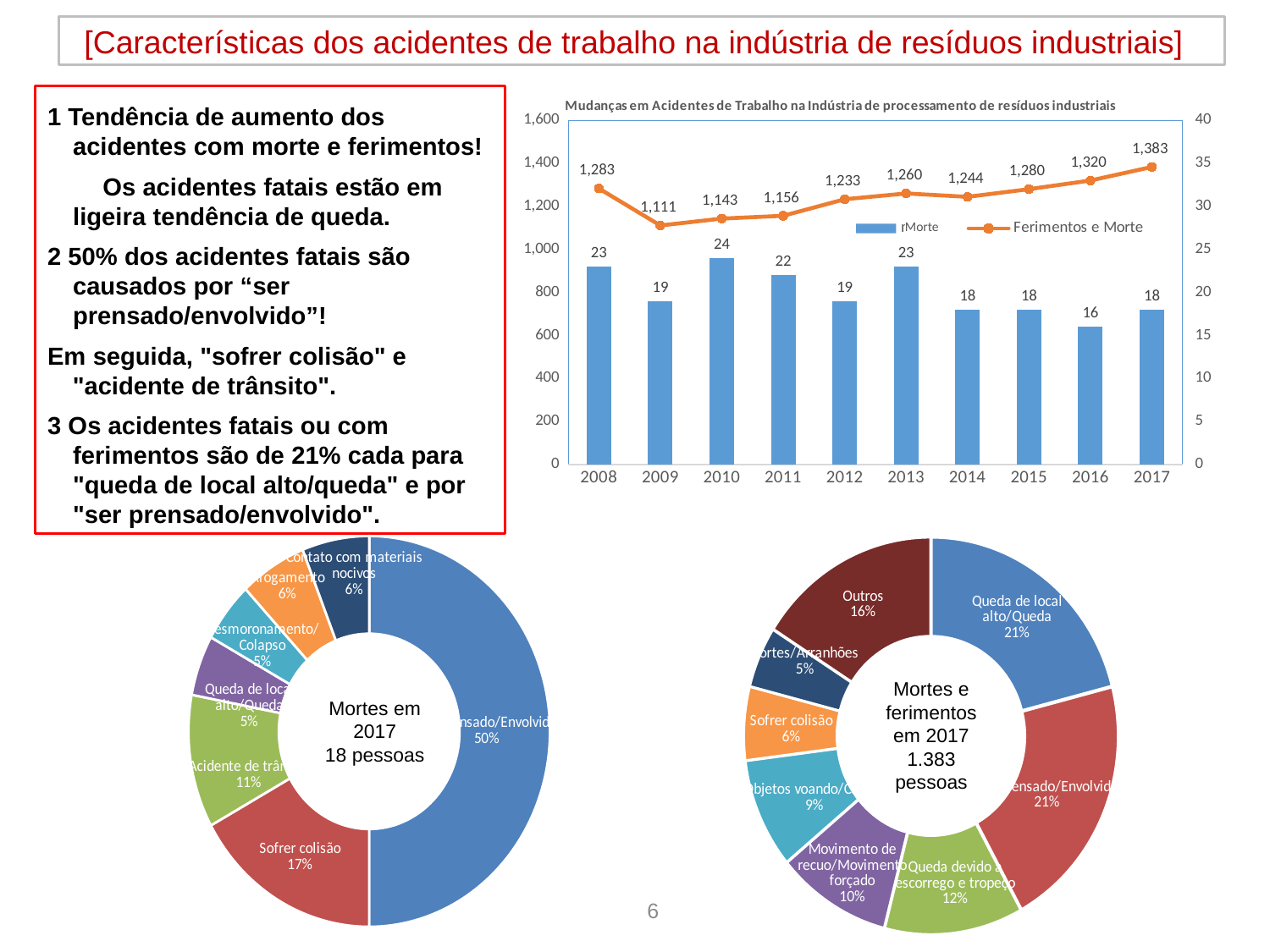
In the chart 'Mudanças em Acidentes de Trabalho na Indústria de processamento de resíduos industriais', which year has the lowest 'Morte' value? 2016 In the chart 'Mudanças em Acidentes de Trabalho na Indústria de processamento de resíduos industriais', what is the value of 'Ferimentos e Morte' for 2017? 1,383 In the chart 'Mudanças em Acidentes de Trabalho na Indústria de processamento de resíduos industriais', how many series does the legend list? 2 In the chart 'Mudanças em Acidentes de Trabalho na Indústria de processamento de resíduos industriais', what is the 'Morte' value for 2010? 24 In the chart 'Mudanças em Acidentes de Trabalho na Indústria de processamento de resíduos industriais', which year has the lowest 'Ferimentos e Morte' value? 2009 In the donut chart 'Mortes em 2017 18 pessoas', what share is 'Sofrer colisão'? 17% What kind of chart is 'Mudanças em Acidentes de Trabalho na Indústria de processamento de resíduos industriais'? Combined bar and line chart In the chart 'Mudanças em Acidentes de Trabalho na Indústria de processamento de resíduos industriais', by how much did 'Ferimentos e Morte' increase from 2008 to 2017? 100 In the donut chart 'Mortes e ferimentos em 2017 1.383 pessoas', what share is 'Outros'? 16% In the chart 'Mudanças em Acidentes de Trabalho na Indústria de processamento de resíduos industriais', how many years are shown on the x axis? 10 In the chart 'Mudanças em Acidentes de Trabalho na Indústria de processamento de resíduos industriais', which year has the highest 'Morte' value? 2010 In the chart 'Mudanças em Acidentes de Trabalho na Indústria de processamento de resíduos industriais', which year has the larger 'Morte' value, 2011 or 2012? 2011